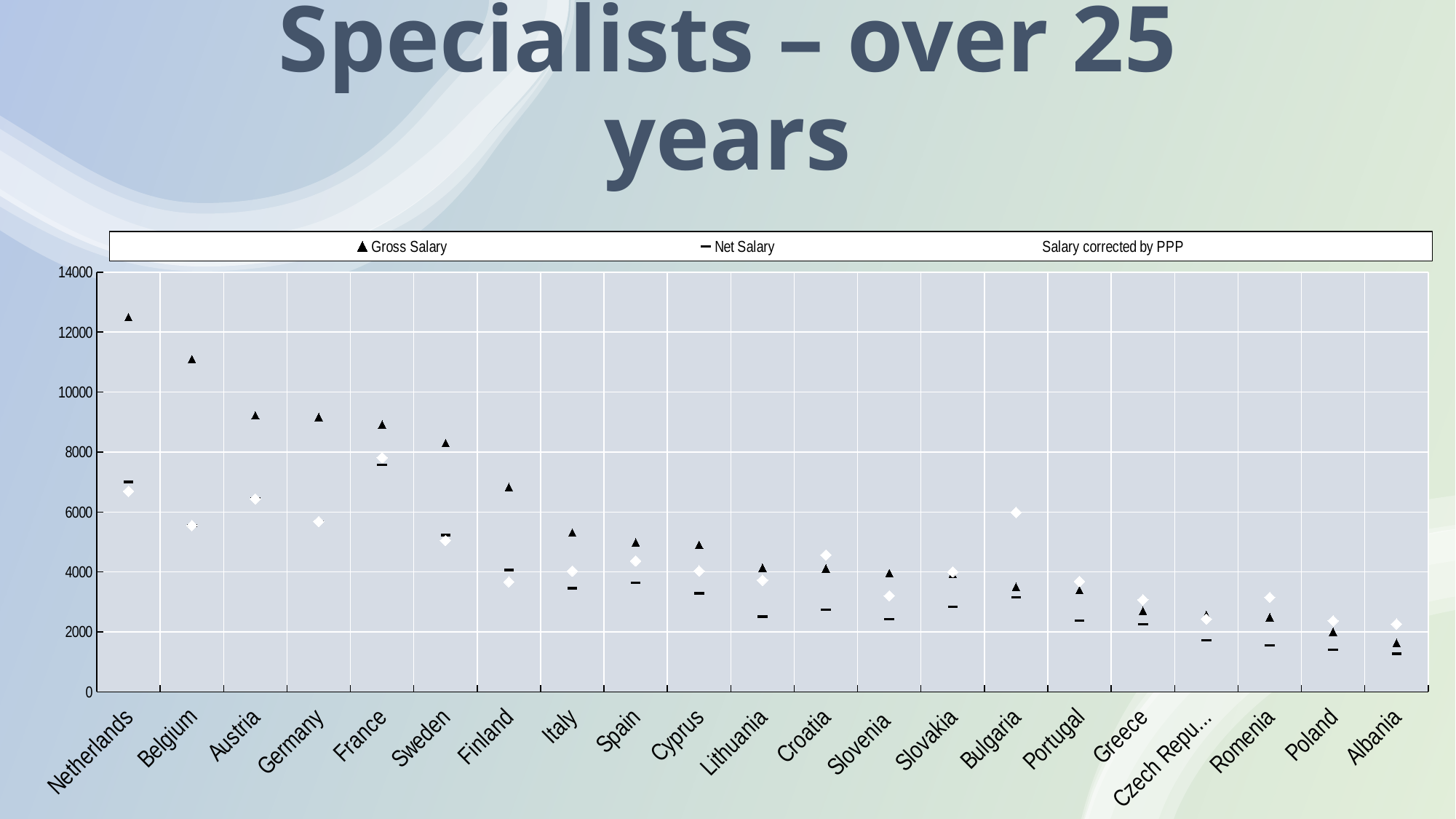
Is the Net Salary for Netherlands greater or less than 8000? less Which marker shape does the legend use for Gross Salary? triangle Is the Gross Salary for Belgium greater or less than 10000? greater How many countries are shown on the x axis? 21 How many series does the legend list? 3 Which country has the lowest Gross Salary? Albania Which is larger for Bulgaria, the Gross Salary or the Salary corrected by PPP? Salary corrected by PPP Do the Gross Salary values generally rise or fall from left to right along the x axis? fall Which country has the highest Gross Salary? Netherlands What kind of chart is shown on the slide? scatter chart Is the Gross Salary for Finland greater or less than 8000? less